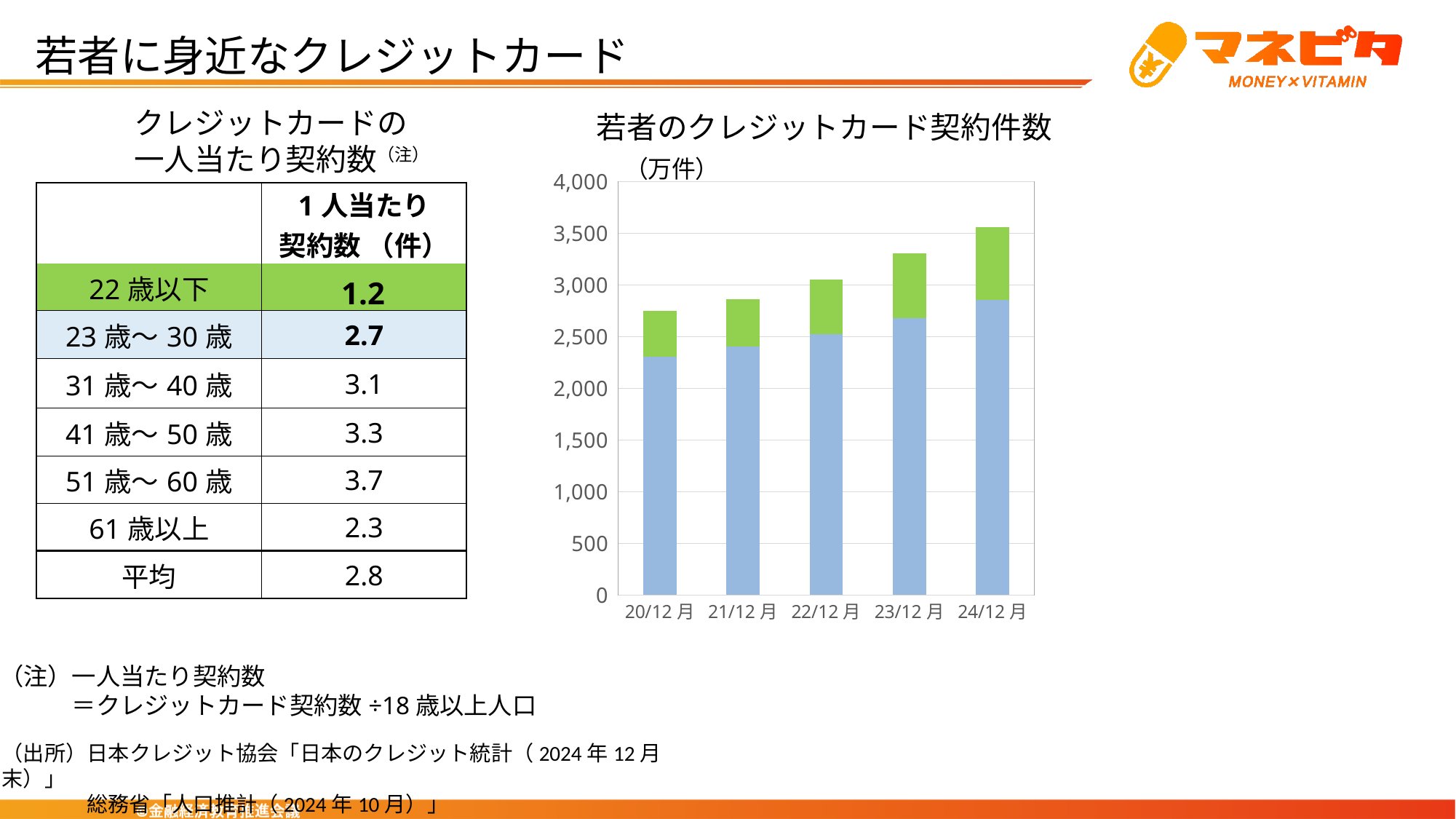
What kind of chart is shown on the right side of the slide? stacked bar chart What is the title of the chart on the right? 若者のクレジットカード契約件数 Is the total bar height for 20/12月 greater or less than 2,500? greater What unit is shown above the y axis of the chart? 万件 Is the blue (bottom) segment for 20/12月 greater or less than 2,500? less Is the total bar height for 23/12月 greater or less than 3,000? greater How many time periods (bars) are plotted in the chart? 5 Which period has the tallest bar in the chart? 24/12月 Which bar is taller, 23/12月 or 21/12月? 23/12月 Do the bar totals rise or fall from 20/12月 to 24/12月? rise Which period has the shortest bar in the chart? 20/12月